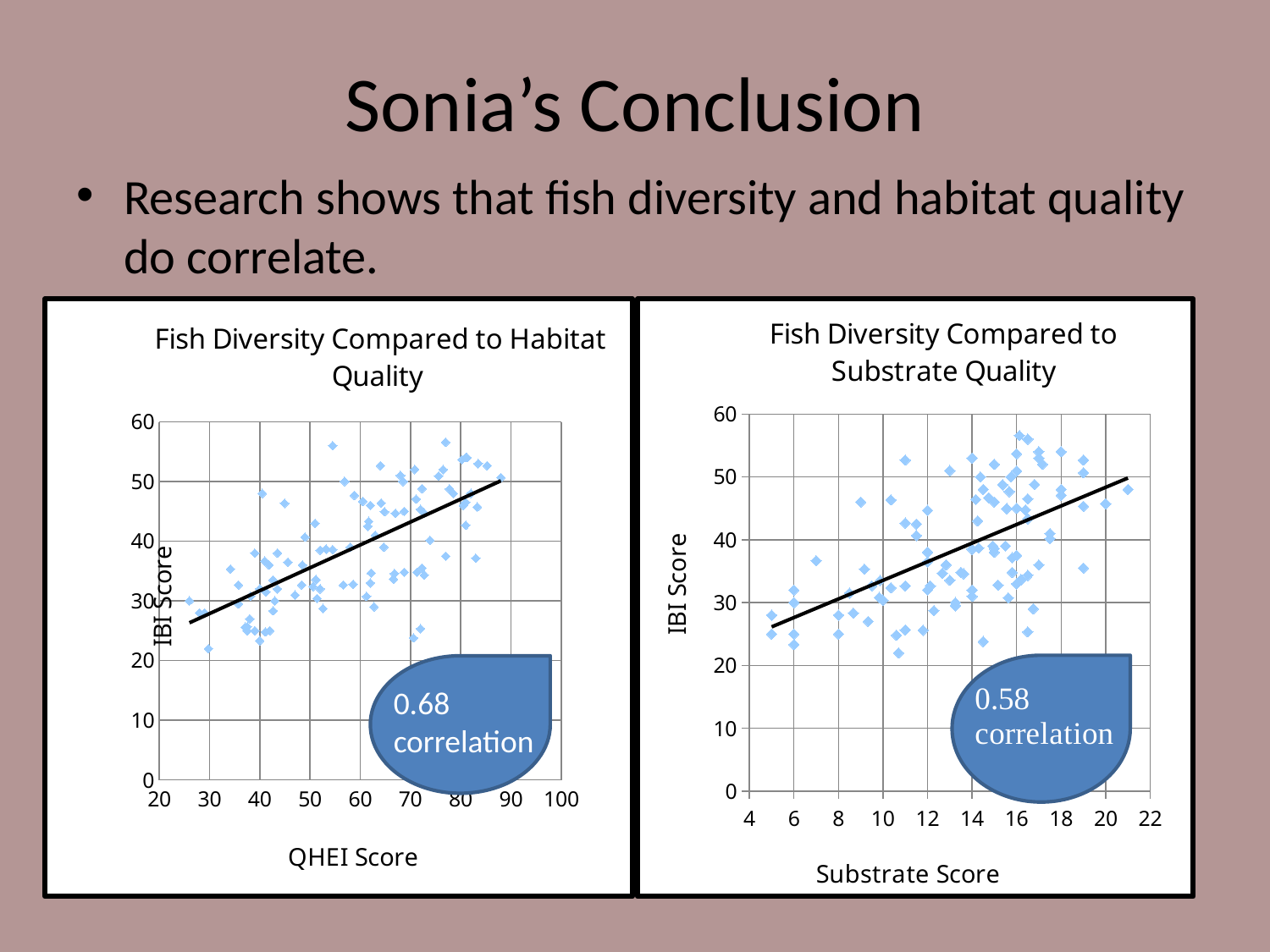
Which chart shows the stronger correlation, the Habitat Quality chart on the left or the Substrate Quality chart on the right? Habitat Quality chart (0.68) What is the x-axis title of the "Fish Diversity Compared to Substrate Quality" chart? Substrate Score In the "Fish Diversity Compared to Substrate Quality" chart, does the trend line rise or fall as Substrate Score increases? Rise What is the x-axis title of the "Fish Diversity Compared to Habitat Quality" chart? QHEI Score In the "Fish Diversity Compared to Habitat Quality" chart, do IBI Scores generally rise or fall as QHEI Score increases? Rise What kind of chart is the "Fish Diversity Compared to Habitat Quality" chart on the left? Scatter chart What correlation value is shown on the "Fish Diversity Compared to Substrate Quality" chart? 0.58 In the "Fish Diversity Compared to Habitat Quality" chart, what is the maximum value shown on the y axis? 60 What correlation value is shown on the "Fish Diversity Compared to Habitat Quality" chart? 0.68 What kind of chart is the "Fish Diversity Compared to Substrate Quality" chart on the right? Scatter chart In the "Fish Diversity Compared to Substrate Quality" chart, what is the maximum value shown on the x axis? 22 What is the difference between the correlation values shown on the two charts? 0.10